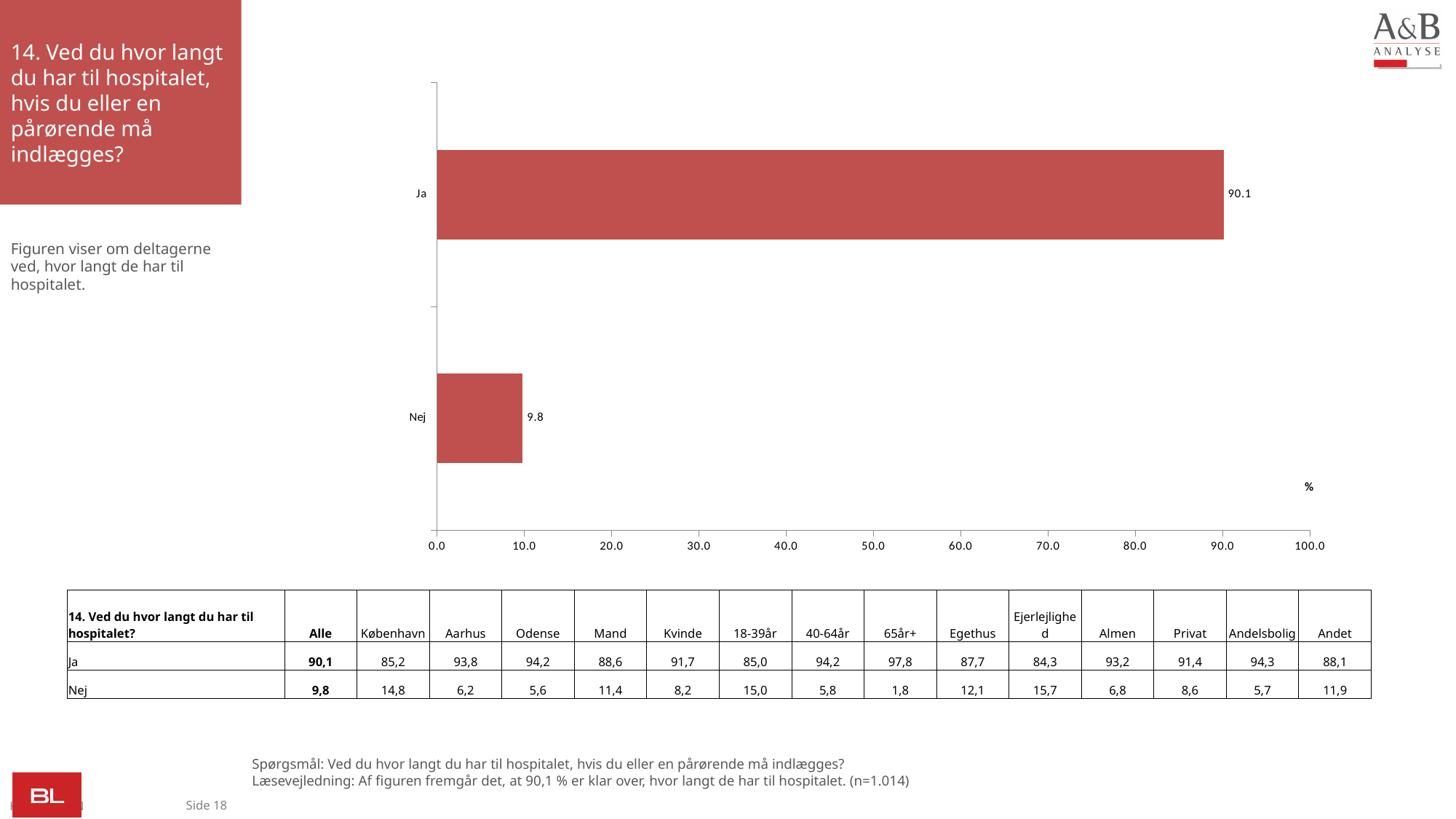
What is the value for "Ja" in the bar chart? 90.1 What unit label is shown near the x axis of the bar chart? % How many categories are shown in the bar chart? 2 Which is larger in the bar chart, the value for "Ja" or the value for "Nej"? Ja What is the difference between the values for "Ja" and "Nej" in the bar chart? 80.3 What kind of chart is shown on the slide? bar chart Is the value for "Nej" greater or less than 20.0? less Is the value for "Ja" greater or less than 80.0? greater What is the value for "Nej" in the bar chart? 9.8 Which category has the lowest value in the bar chart? Nej Which category has the highest value in the bar chart? Ja What is the maximum value shown on the x axis of the bar chart? 100.0